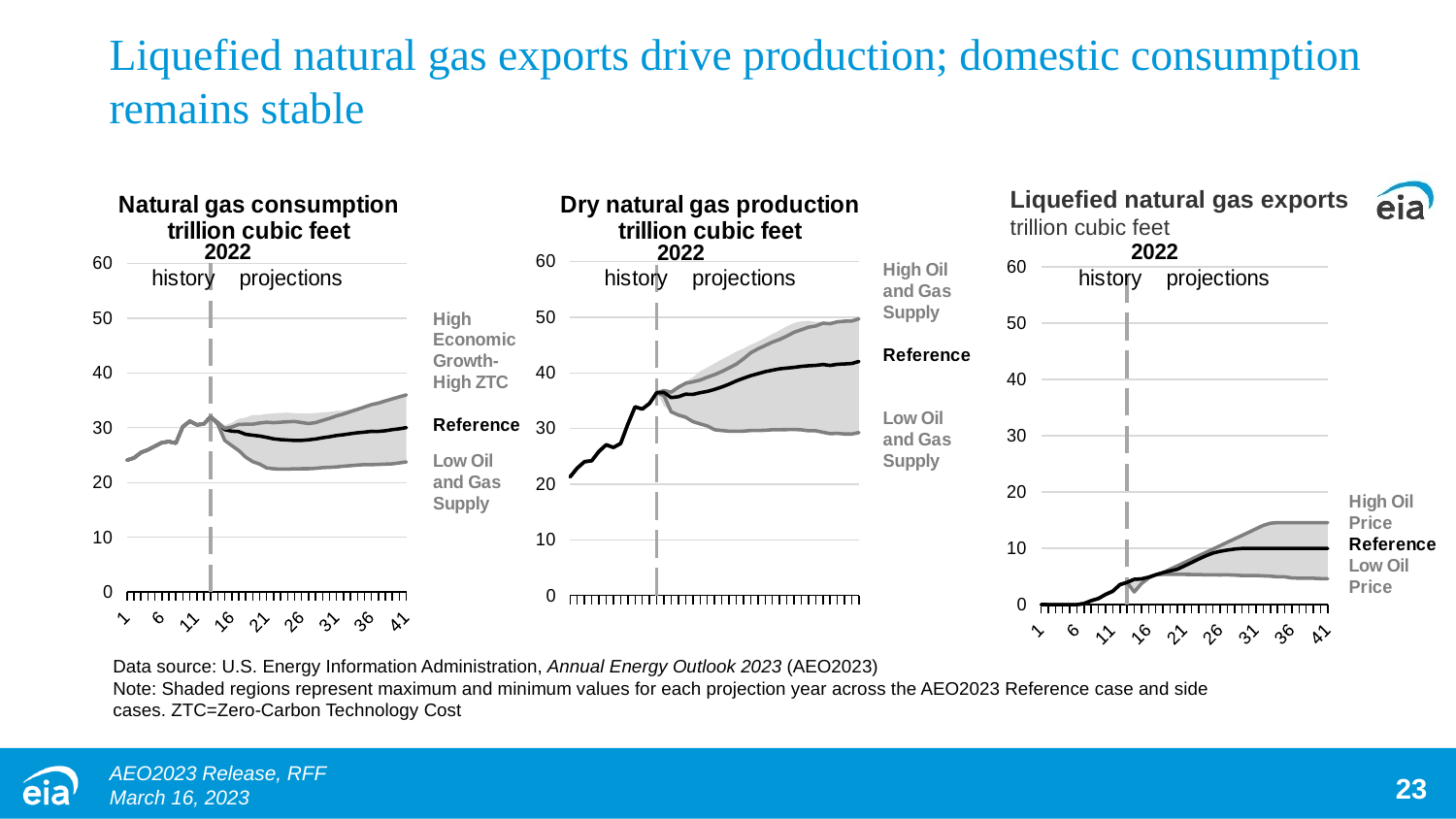
In the "Liquefied natural gas exports" chart, what year does the dashed vertical line separating history from projections mark? 2022 In the "Dry natural gas production" chart, is the value of the Low Oil and Gas Supply line at the end of the projection period greater or less than 40? less In the "Liquefied natural gas exports" chart, is the value of the High Oil Price line at the end of the projection period greater or less than 10? greater How many charts are shown on the slide? 3 In the "Natural gas consumption" chart, is the value of the High Economic Growth-High ZTC line at the end of the projection period greater or less than 30? greater What kind of chart is the "Natural gas consumption" chart? line chart In the "Natural gas consumption" chart, which is larger at the end of the projection period, the High Economic Growth-High ZTC line or the Low Oil and Gas Supply line? High Economic Growth-High ZTC In the "Natural gas consumption" chart, how many scenario labels are listed to the right of the plot? 3 In the "Liquefied natural gas exports" chart, do the values generally rise or fall along the x axis? rise What unit is used on the y axis of the "Dry natural gas production" chart? trillion cubic feet In the "Dry natural gas production" chart, which scenario is highest at the end of the projection period? High Oil and Gas Supply